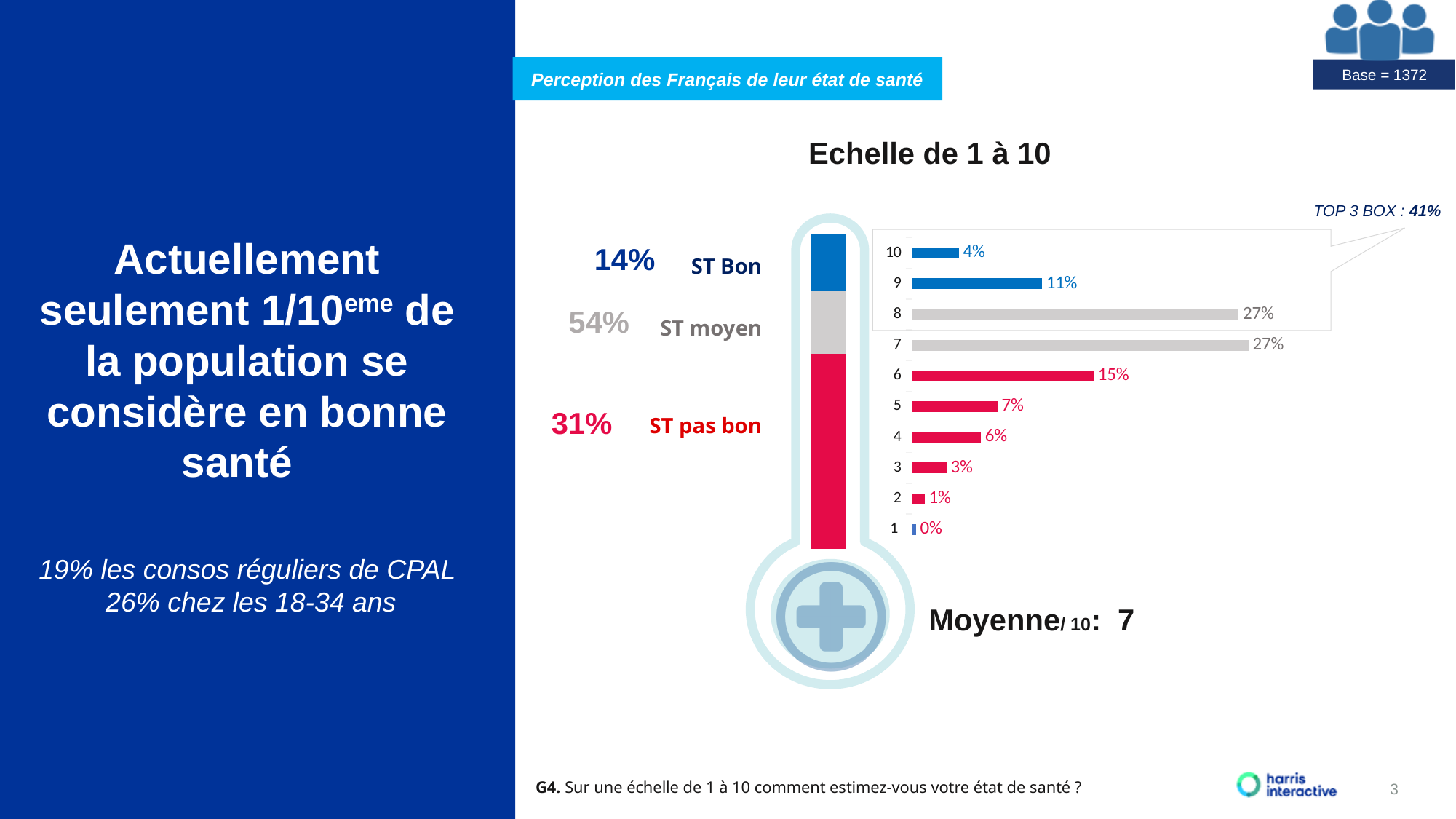
What percentage is shown for "ST moyen" next to the thermometer? 54% In the "Echelle de 1 à 10" chart, how many score categories are plotted? 10 In the "Echelle de 1 à 10" chart, what is the difference between the percentage for score 8 and the percentage for score 9? 16% What percentage is shown for "ST pas bon" next to the thermometer? 31% What type of chart is shown under the title "Echelle de 1 à 10"? bar chart In the "Echelle de 1 à 10" chart, which score has the lowest percentage? 1 In the "Echelle de 1 à 10" chart, what percentage of respondents gave a score of 6? 15% In the "Echelle de 1 à 10" chart, what percentage of respondents gave a score of 10? 4% In the "Echelle de 1 à 10" chart, which has a higher percentage: score 5 or score 4? score 5 What is the "TOP 3 BOX" value shown on the slide? 41% In the "Echelle de 1 à 10" chart, what is the combined percentage for scores 3, 2 and 1? 4% In the "Echelle de 1 à 10" chart, what percentage of respondents gave a score of 9? 11%